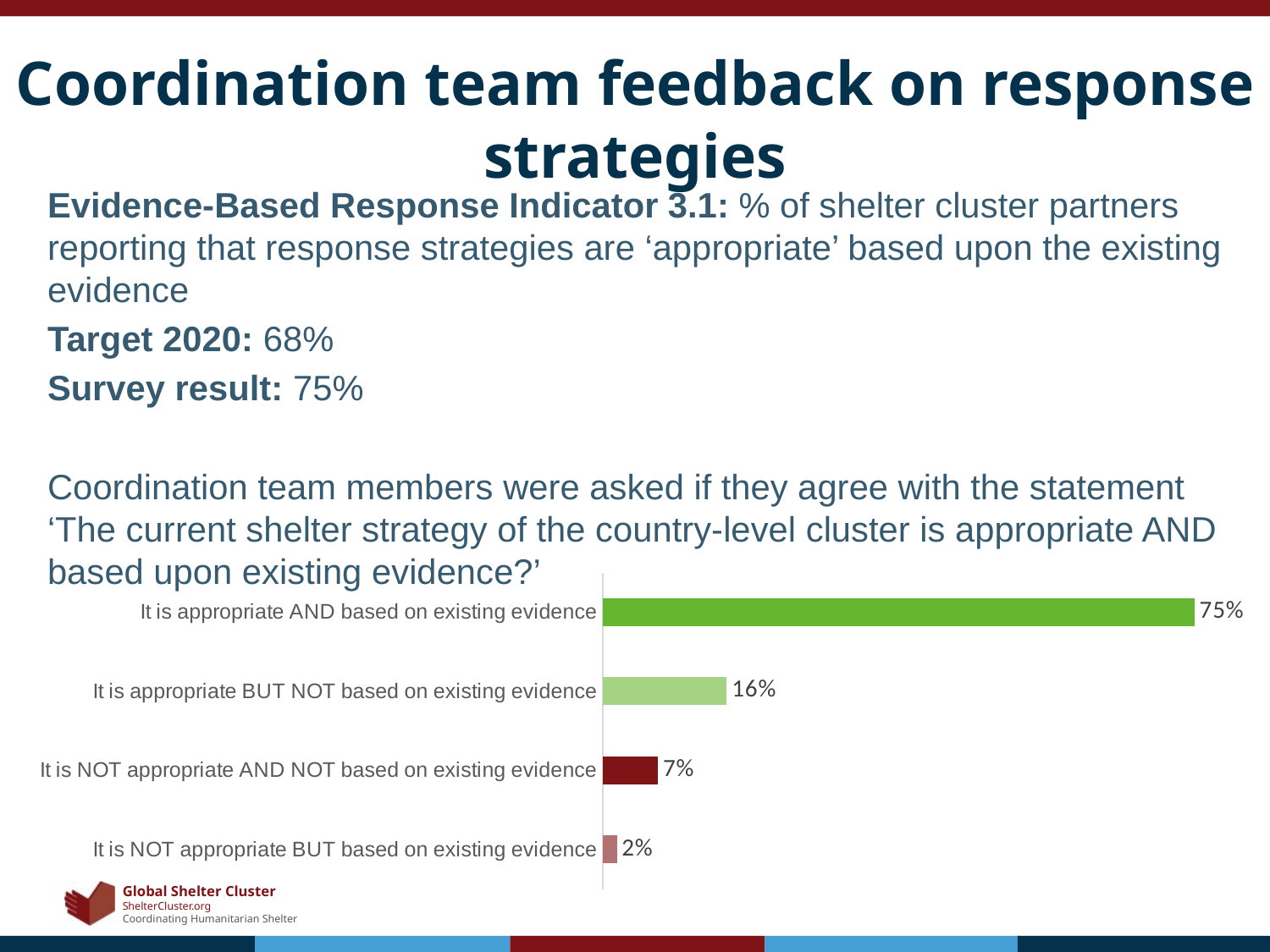
Which response category has the highest percentage? It is appropriate AND based on existing evidence What percentage of coordination team members said the strategy is appropriate AND based on existing evidence? 75% Which is larger: the percentage for 'It is appropriate BUT NOT based on existing evidence' or for 'It is NOT appropriate AND NOT based on existing evidence'? It is appropriate BUT NOT based on existing evidence What type of chart is shown on the slide? Bar chart What is the difference in percentage points between 'It is NOT appropriate AND NOT based on existing evidence' and 'It is NOT appropriate BUT based on existing evidence'? 5 What percentage said the strategy is NOT appropriate AND NOT based on existing evidence? 7% What is the difference in percentage points between 'It is appropriate AND based on existing evidence' and 'It is appropriate BUT NOT based on existing evidence'? 59 What percentage said the strategy is appropriate BUT NOT based on existing evidence? 16% What percentage said the strategy is NOT appropriate BUT based on existing evidence? 2% What colour is the bar for 'It is appropriate AND based on existing evidence'? Green How many response categories are shown in the chart? 4 Which response category has the lowest percentage? It is NOT appropriate BUT based on existing evidence